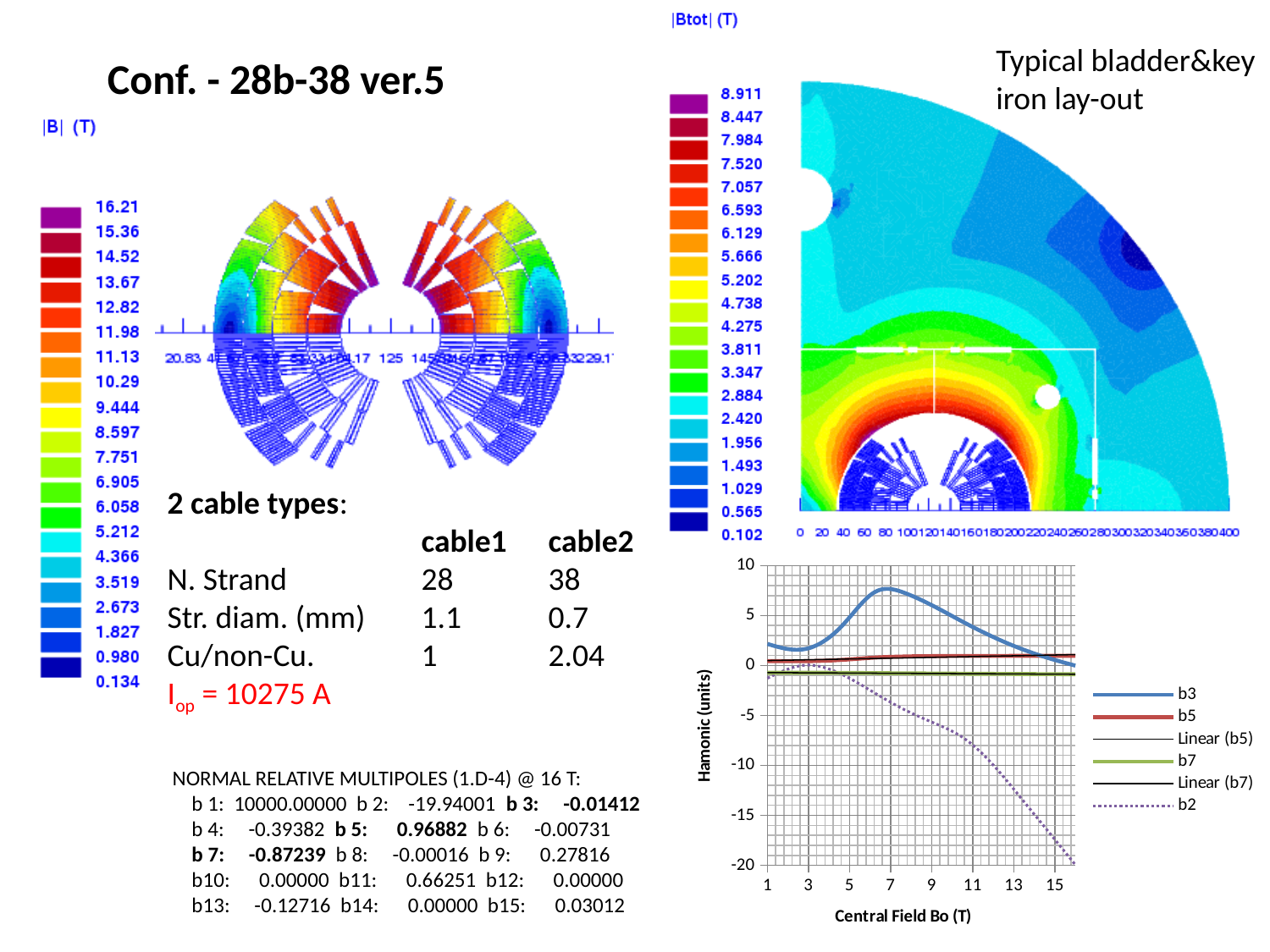
In the Harmonic chart, is the value of b2 at 11 T greater or less than -5? less In the Harmonic chart, at 7 T, which series has the larger value, b3 or b5? b3 What is the y-axis title of the Harmonic chart? Hamonic (units) In the Harmonic chart, is the value of b2 at 15 T greater or less than -15? less In the Harmonic chart, which series reaches the highest value on the plot? b3 In the Harmonic chart, which series reaches the lowest value on the plot? b2 In the Harmonic chart, does the b2 series rise or fall as Central Field Bo increases? fall In the Harmonic chart, is the value of b3 at 7 T greater or less than 5? greater What kind of chart is the chart at the bottom right of the slide (Harmonic vs Central Field Bo)? line chart What is the x-axis title of the Harmonic chart? Central Field Bo (T) How many series does the legend of the Harmonic chart list? 6 In the Harmonic chart, at 13 T, which series has the larger value, b7 or b2? b7